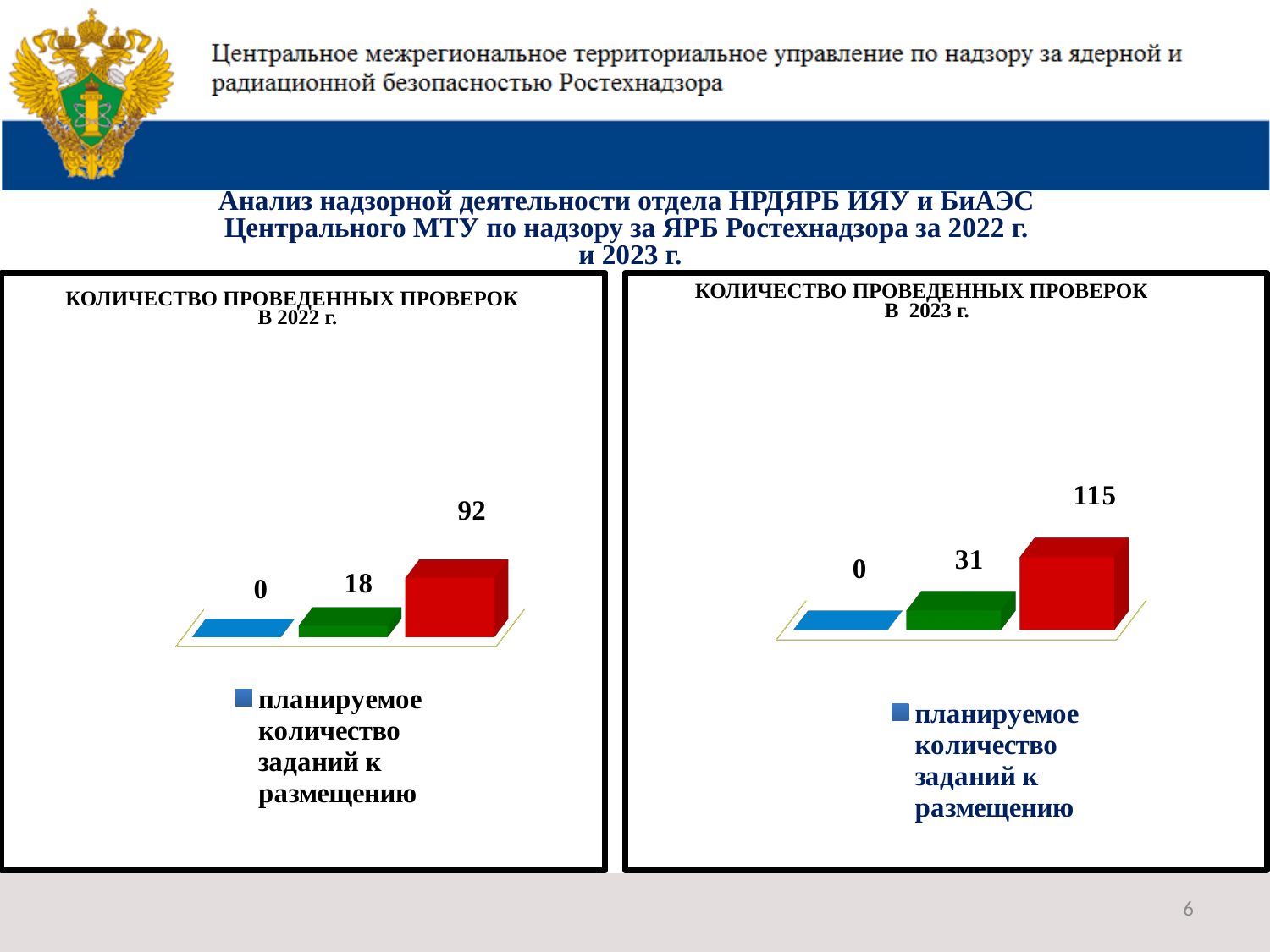
In the right chart (2023), what value is shown for the red bar? 115 In the left chart (2022), what value is shown for the red bar? 92 What is the title of the left chart? КОЛИЧЕСТВО ПРОВЕДЕННЫХ ПРОВЕРОК В 2022 г. In the right chart (2023), what is the difference between the red bar and the green bar? 84 In the left chart (2022), what value is shown for the blue bar labelled 'планируемое количество заданий к размещению'? 0 In the left chart (2022), which bar has the lowest value? the blue bar (0) In the right chart (2023), which bar has the highest value? the red bar (115) How many bars are plotted in the left chart (2022)? 3 Which is larger: the red bar in the 2022 chart or the red bar in the 2023 chart? the red bar in the 2023 chart (115) In the right chart (2023), what value is shown for the green bar? 31 In the left chart (2022), what value is shown for the green bar? 18 What type of chart is used in the right chart (2023)? bar chart